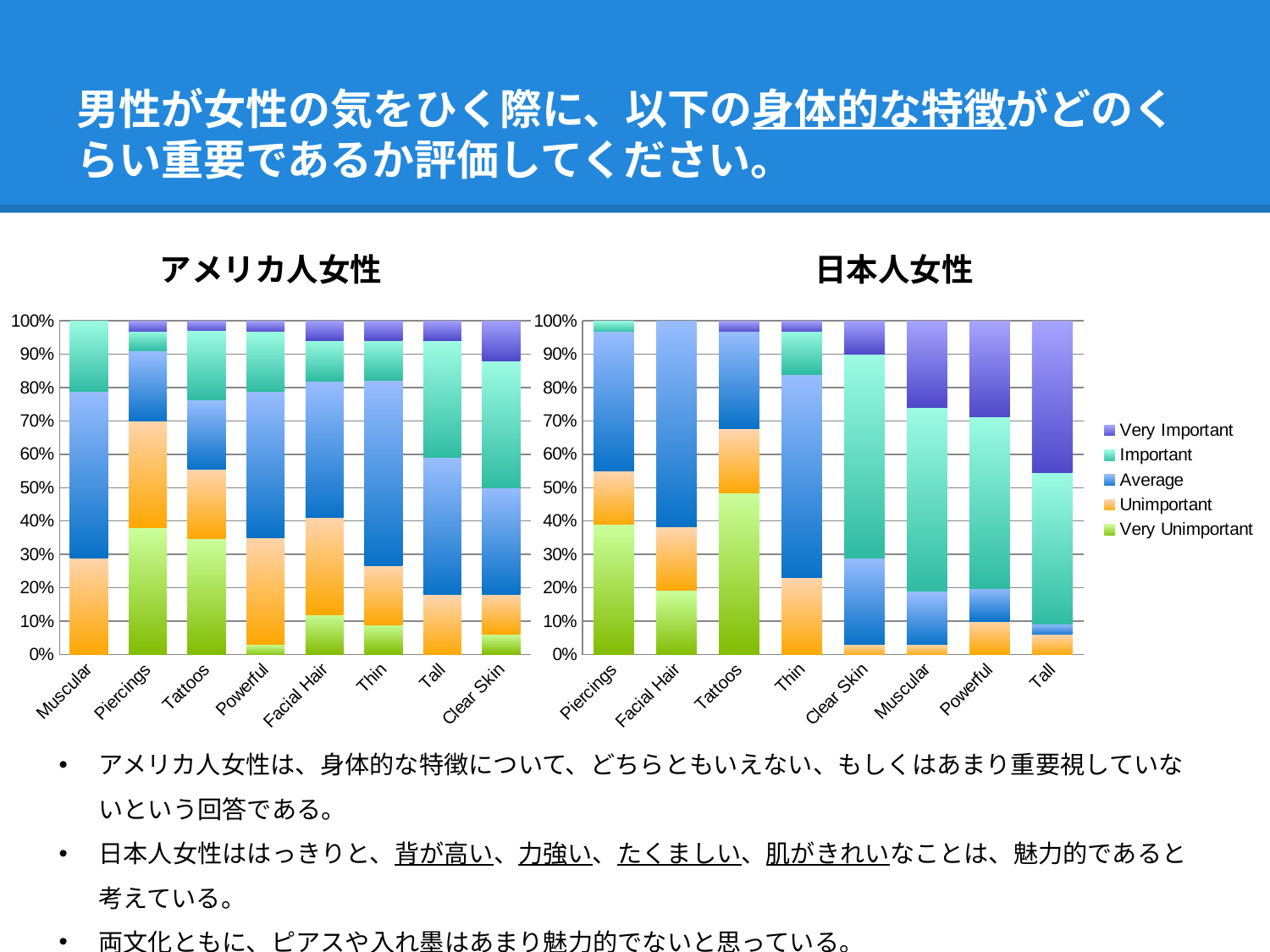
In the right chart titled 日本人女性, which category has the largest Very Important share? Tall In the right chart titled 日本人女性, which category has the largest Very Unimportant share? Tattoos How many categories are shown on the x axis of the right chart titled 日本人女性? 8 In the left chart titled アメリカ人女性, which has the larger Important share, Tall or Muscular? Tall Which series is shown in purple in the legend? Very Important In the left chart titled アメリカ人女性, which category has the largest Very Important share? Clear Skin How many categories are shown on the x axis of the left chart titled アメリカ人女性? 8 In the right chart titled 日本人女性, which has the larger Very Important share, Tall or Piercings? Tall In the left chart titled アメリカ人女性, is the Unimportant share for Muscular greater or less than 40%? less How many series does the legend list? 5 In the right chart titled 日本人女性, is the Very Unimportant share for Tattoos greater or less than 40%? greater What kind of chart is the left chart titled アメリカ人女性? Stacked bar chart